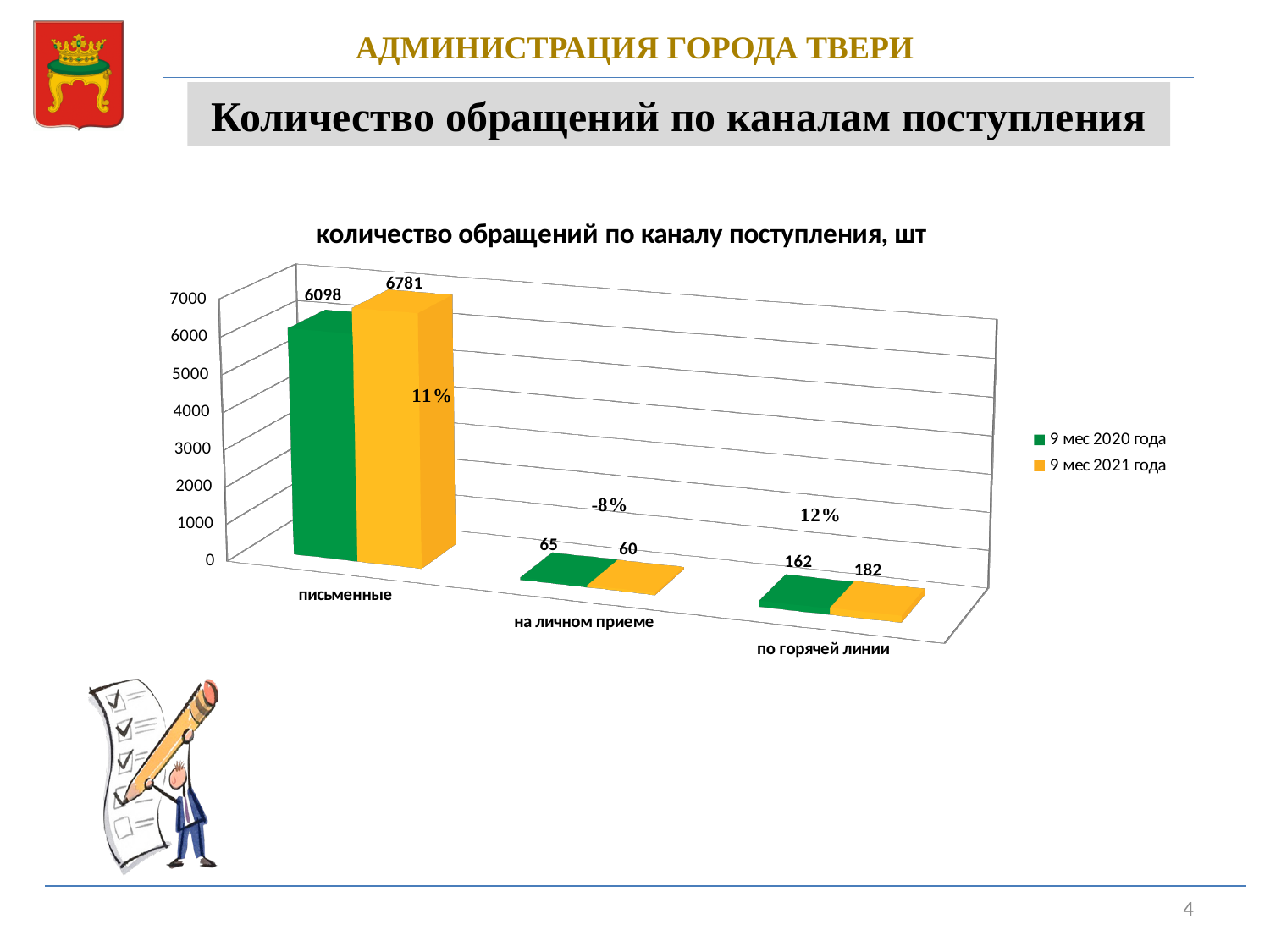
What is the value for на личном приеме in the 9 мес 2020 года series? 65 How many categories are shown on the x axis? 3 What is the value for по горячей линии in the 9 мес 2021 года series? 182 What kind of chart is shown on the slide? bar chart Which category has the lowest value in the 9 мес 2021 года series? на личном приеме Is the value for письменные in the 9 мес 2020 года series greater or less than 5000? greater Which is larger for по горячей линии: the 9 мес 2020 года value or the 9 мес 2021 года value? 9 мес 2021 года What is the difference between the 9 мес 2021 года and 9 мес 2020 года values for письменные? 683 Which category has the highest value in the 9 мес 2020 года series? письменные How many series does the legend list? 2 What is the value for письменные in the 9 мес 2021 года series? 6781 What is the title of the chart? количество обращений по каналу поступления, шт